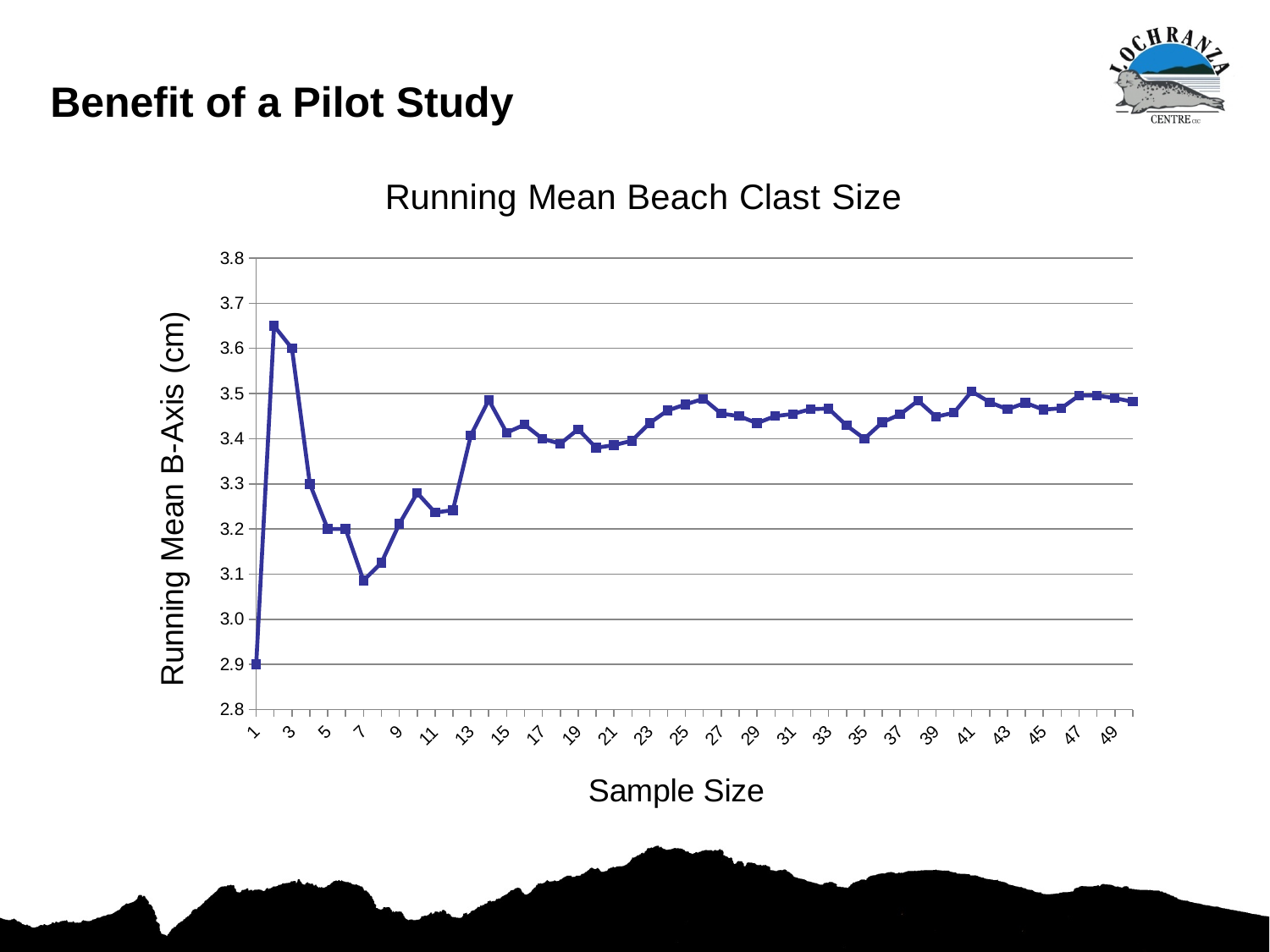
What is the label of the vertical axis? Running Mean B-Axis (cm) What is the running mean B-axis value at sample size 5? 3.2 Which has the larger running mean value: sample size 3 or sample size 7? sample size 3 What is the running mean B-axis value at sample size 3? 3.6 What is the running mean B-axis value at sample size 4? 3.3 At which sample size is the running mean B-axis value lowest? 1 Is the running mean value at sample size 2 greater or less than 3.6? greater What type of chart is shown on the slide? line chart What is the title of the chart? Running Mean Beach Clast Size At which sample size is the running mean B-axis value highest? 2 What is the running mean B-axis value at sample size 1? 2.9